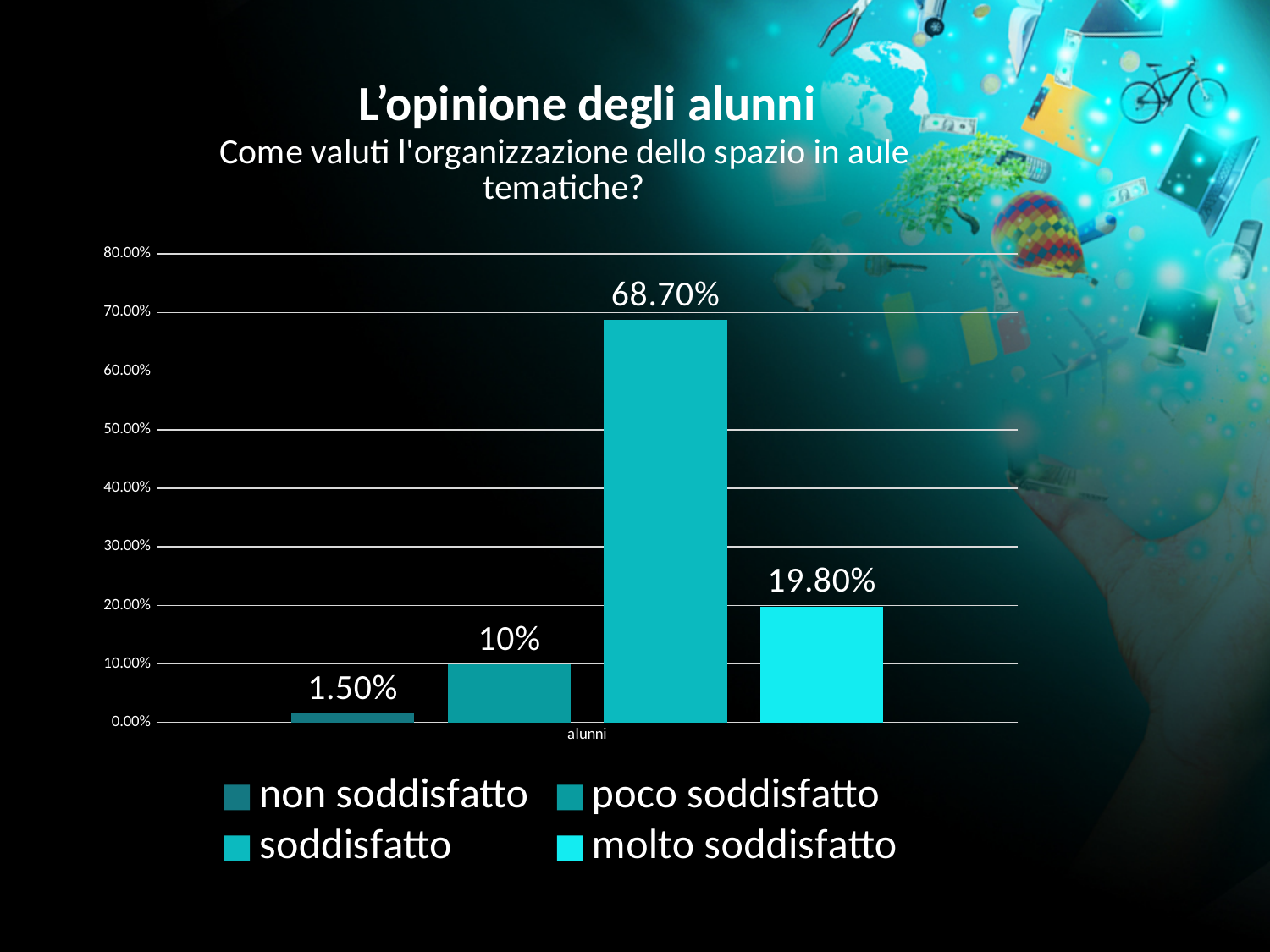
Is the value for "soddisfatto" greater or less than 60.00%? greater What is the value for "soddisfatto"? 68.70% Which series has the highest value? soddisfatto What is the category label shown on the x axis? alunni What is the value for "non soddisfatto"? 1.50% What kind of chart is shown on the slide? bar chart Which is larger, the value for "poco soddisfatto" or the value for "molto soddisfatto"? molto soddisfatto What is the difference between the values for "soddisfatto" and "molto soddisfatto"? 48.90% What is the value for "molto soddisfatto"? 19.80% Which series has the lowest value? non soddisfatto What is the value for "poco soddisfatto"? 10% How many series does the legend list? 4